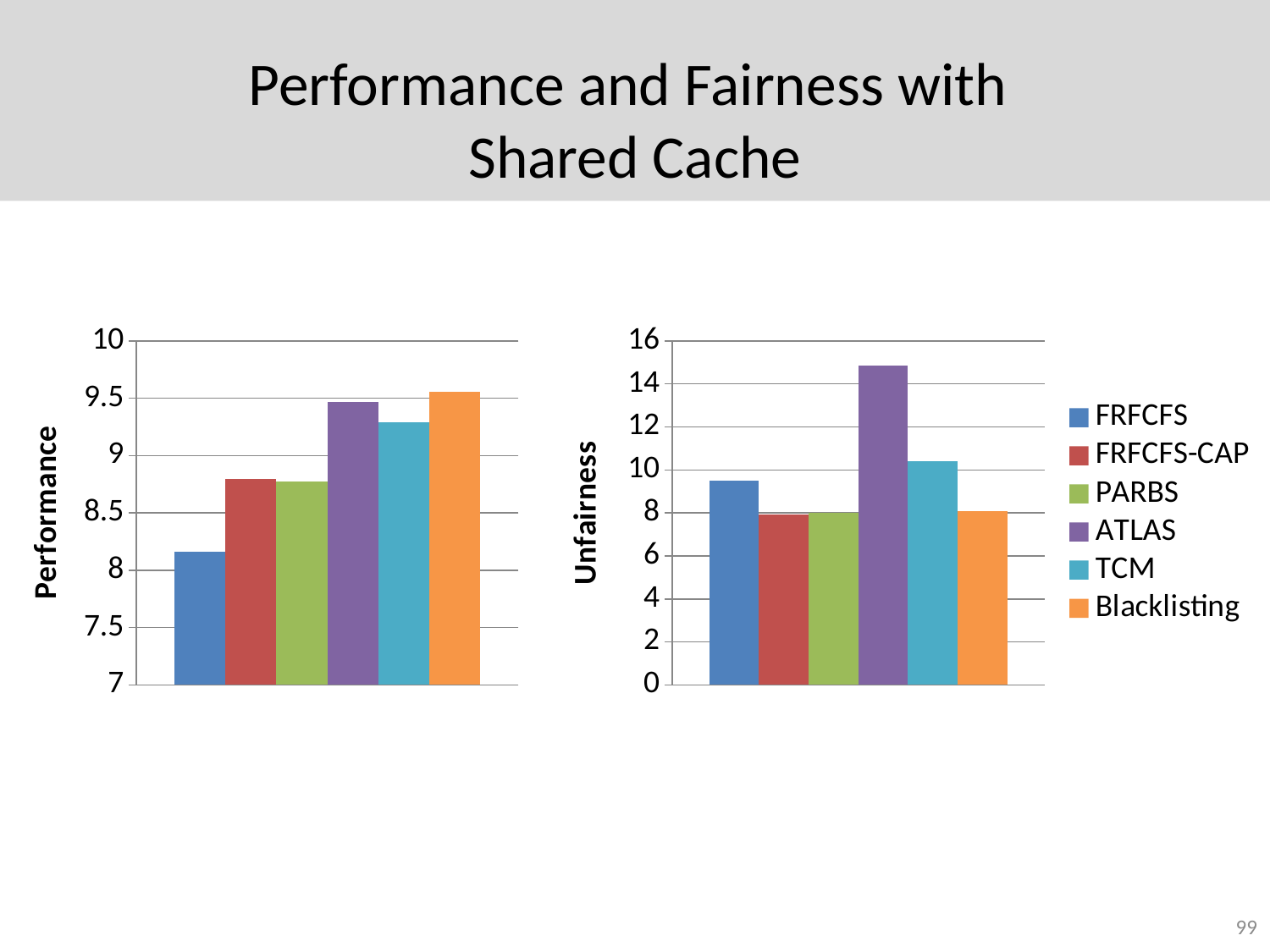
What is the y-axis label of the chart on the right? Unfairness How many series does the legend list? 6 In the Unfairness chart on the right, which is larger, the value for FRFCFS or the value for TCM? TCM In the Unfairness chart on the right, which scheduler has the highest unfairness? ATLAS Which colour represents Blacklisting in the legend? orange In the Unfairness chart on the right, is the value for FRFCFS greater or less than 10? less In the Performance chart on the left, which is larger, the value for ATLAS or the value for TCM? ATLAS In the Performance chart on the left, is the value for ATLAS greater or less than 9? greater In the Performance chart on the left, is the value for FRFCFS greater or less than 8.5? less What kind of chart is the Performance chart on the left? bar chart In the Performance chart on the left, which scheduler has the lowest performance? FRFCFS